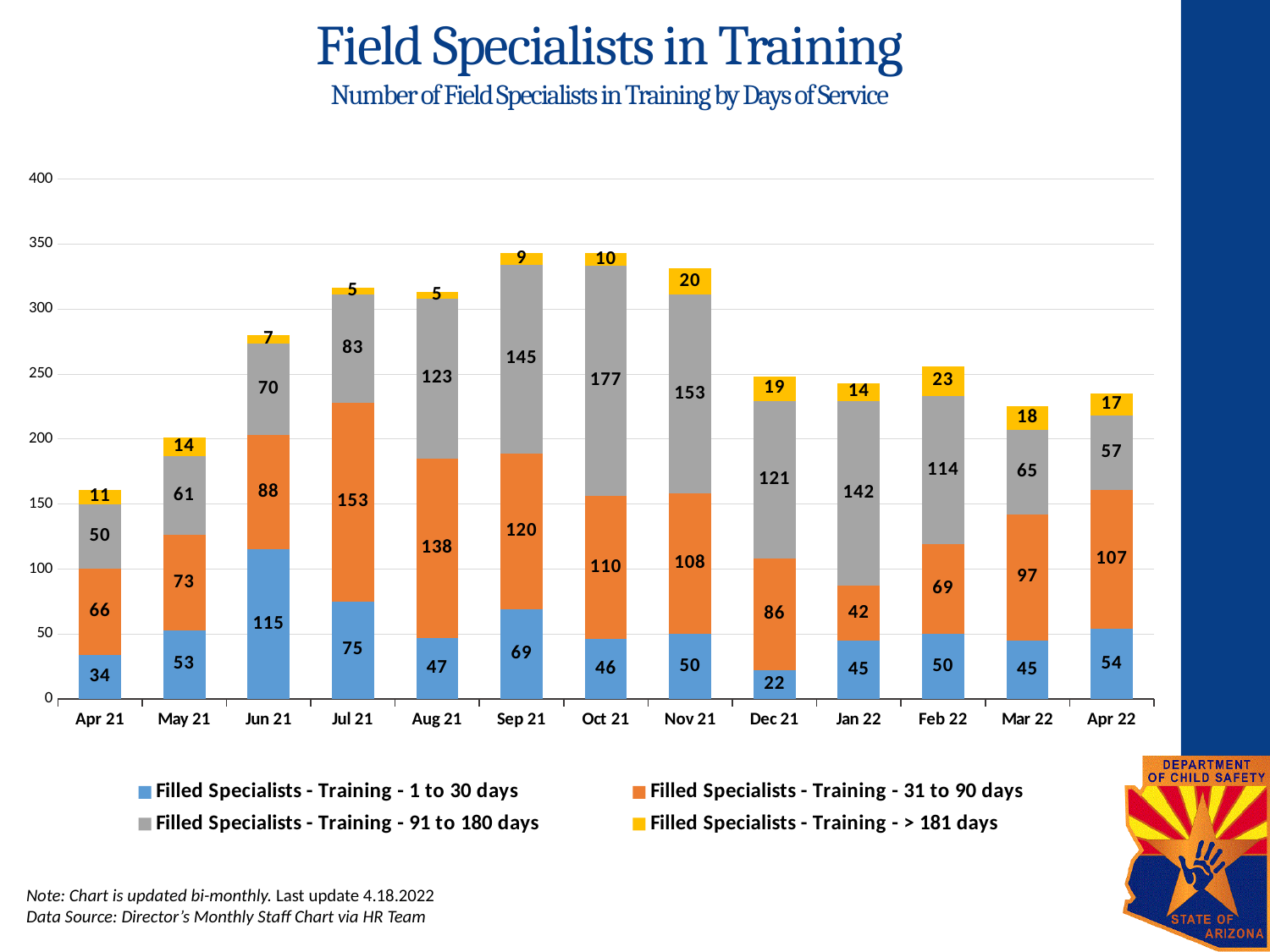
What is the value for Filled Specialists - Training - 1 to 30 days in Jun 21? 115 What is the value for Filled Specialists - Training - > 181 days in Nov 21? 20 What is the value for Filled Specialists - Training - 91 to 180 days in Oct 21? 177 How many series does the legend list? 4 Which month has the highest value for Filled Specialists - Training - > 181 days? Feb 22 How many months are shown on the x axis? 13 What kind of chart is shown on the slide? Stacked bar chart Which month has the highest value for Filled Specialists - Training - 31 to 90 days? Jul 21 Which month has the lowest value for Filled Specialists - Training - 1 to 30 days? Dec 21 Which is larger, the Filled Specialists - Training - 91 to 180 days value for Jan 22 or for Mar 22? Jan 22 What is the difference between the Filled Specialists - Training - 31 to 90 days values for Jul 21 and Apr 21? 87 What is the total of the stacked bar for Apr 21? 161